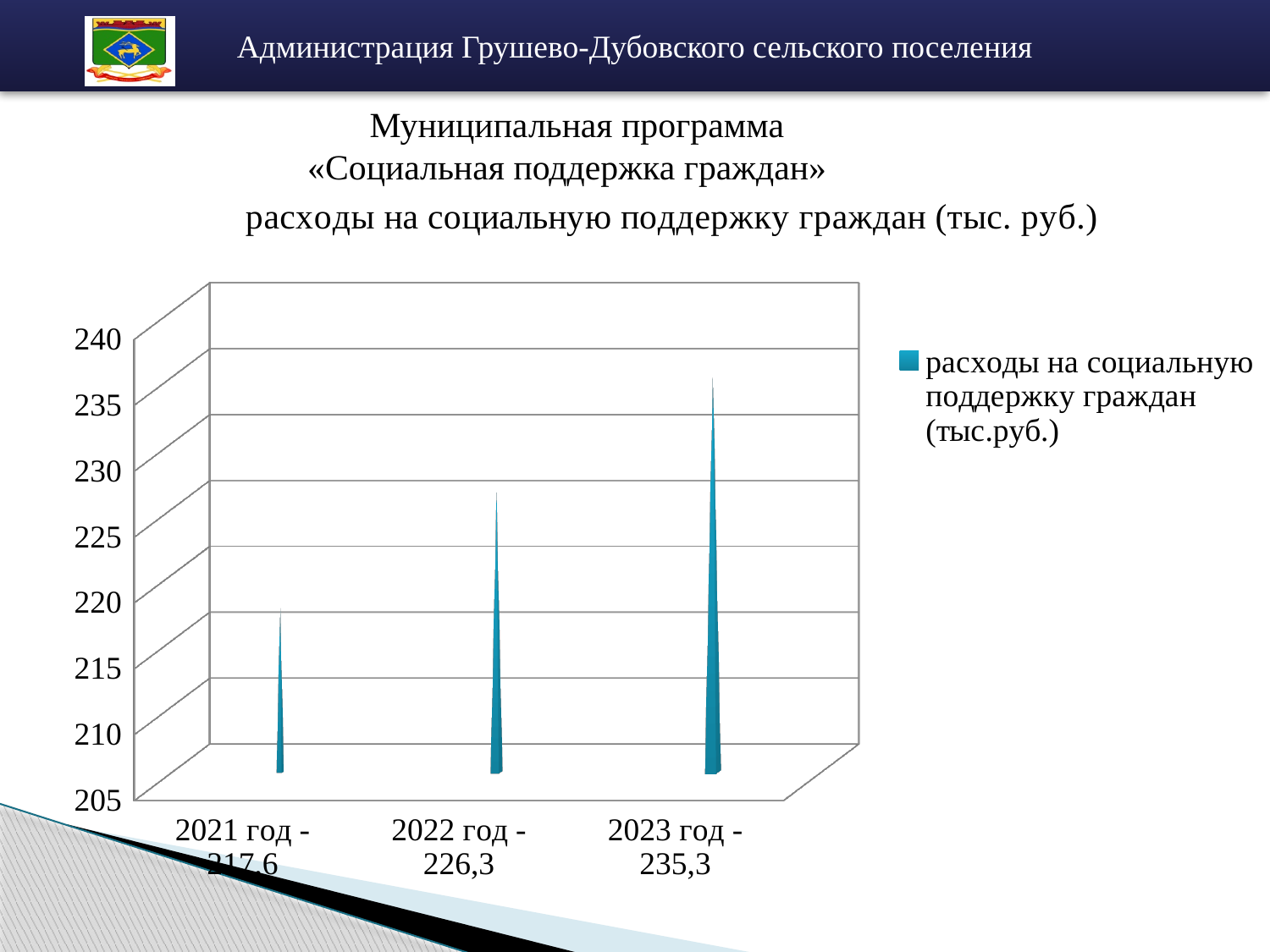
What is the difference between the values for 2022 год and 2021 год? 8,7 Is the value for 2023 год greater or less than 230? greater What is the value for 2022 год? 226,3 Do the values rise or fall from 2021 to 2023? rise How many years are shown on the chart? 3 What is the value for 2021 год? 217,6 What is the difference between the values for 2023 год and 2022 год? 9 Which year has the lowest value? 2021 год What is the value for 2023 год? 235,3 Which is larger, the value for 2022 год or 2023 год? 2023 год How many series does the legend list? 1 Which year has the highest value? 2023 год